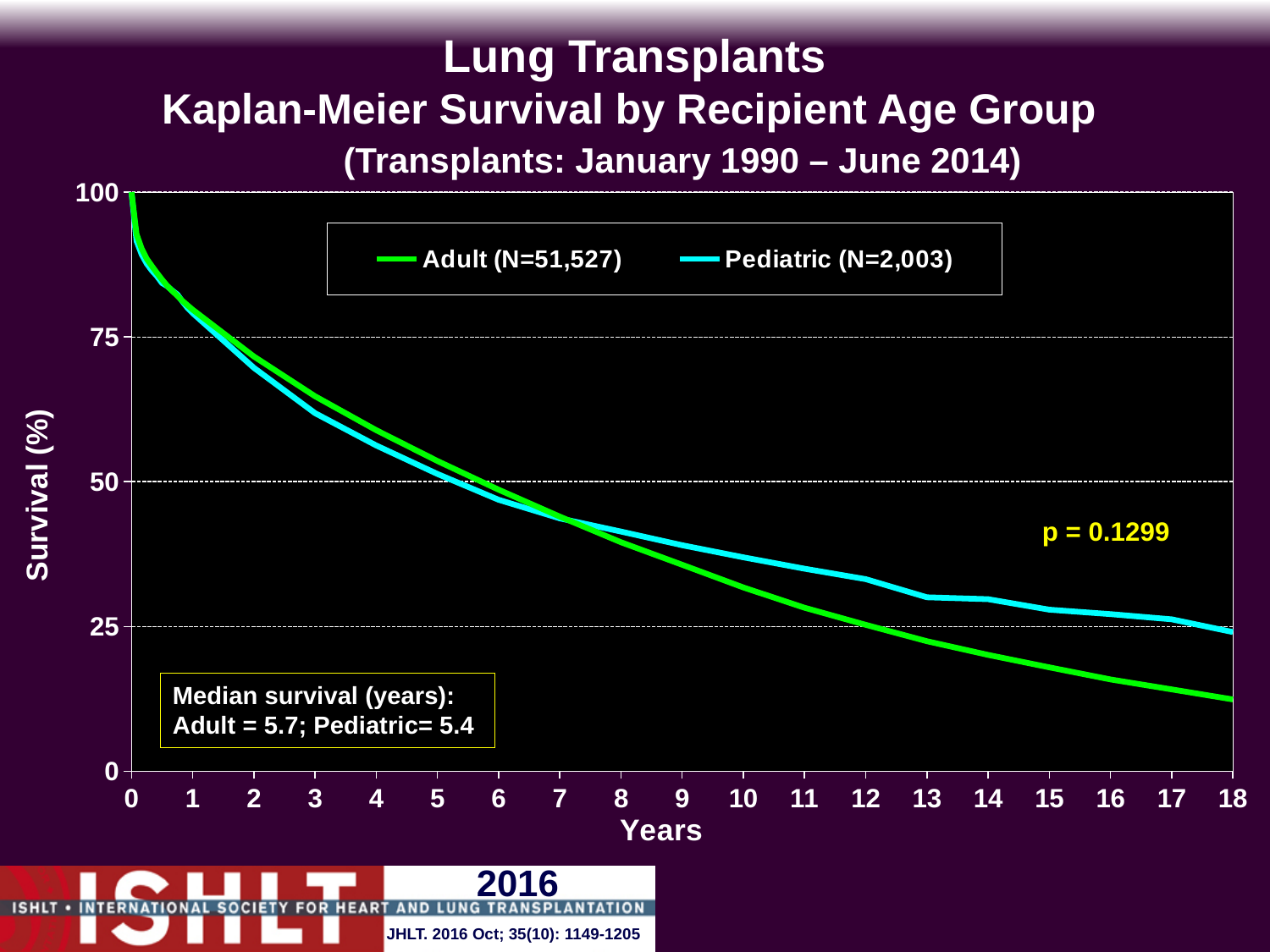
What is the median survival in years for the Adult group? 5.7 What is the difference in median survival (years) between the Adult and Pediatric groups? 0.3 What is the median survival in years for the Pediatric group? 5.4 At 15 years, which group has the higher survival, Adult or Pediatric? Pediatric Is the Pediatric survival at 12 years greater or less than 25%? greater Which group has the higher median survival, Adult or Pediatric? Adult Is the Adult survival at 18 years greater or less than 25%? less How many series does the legend list? 2 Do the survival curves rise or fall as years increase? fall What is the p-value shown on the chart? p = 0.1299 Is the Adult survival at 5 years greater or less than 50%? greater What kind of chart is shown on the slide? line chart